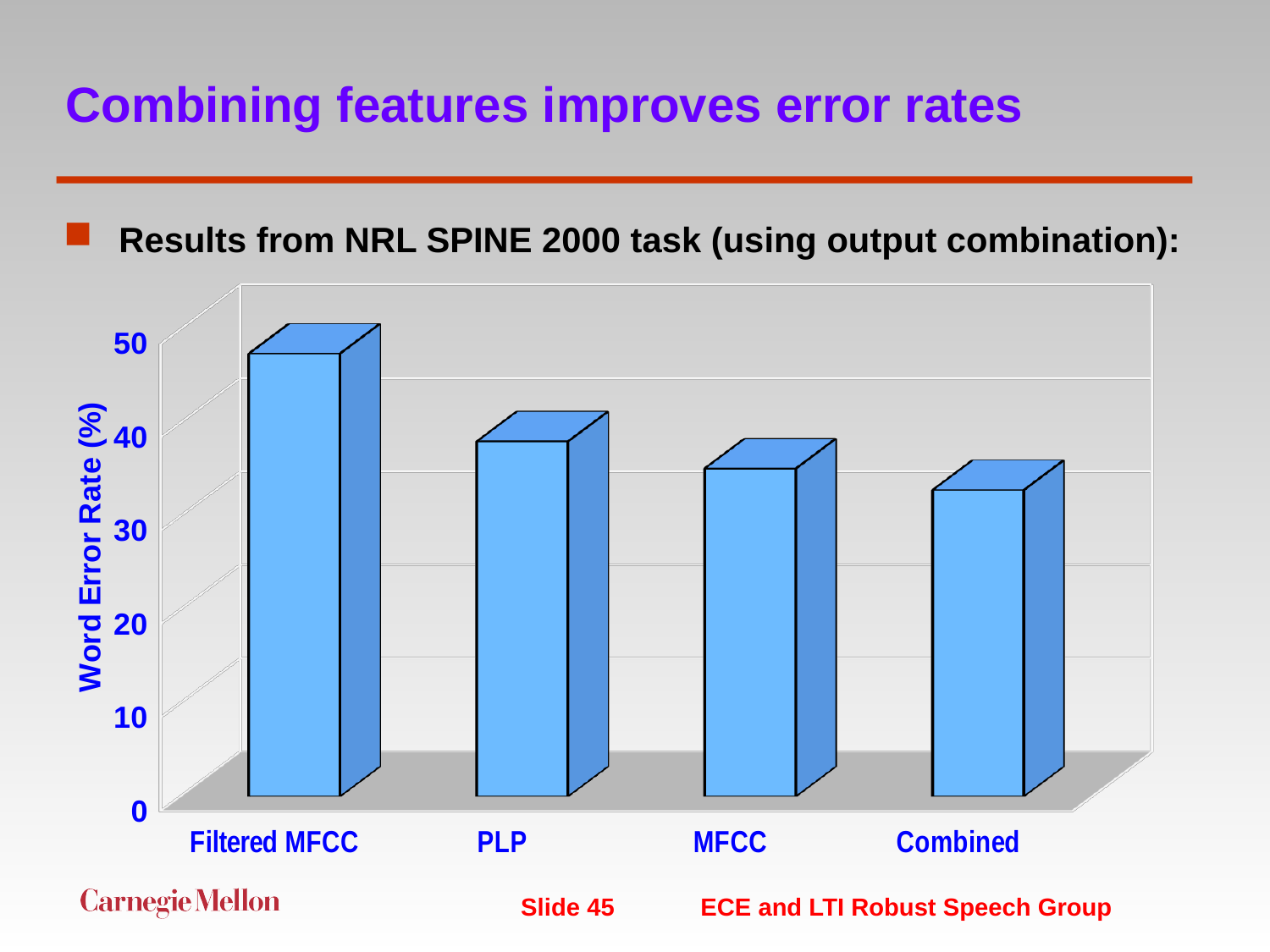
Is the word error rate for MFCC greater or less than 40? less Which has a higher word error rate, Filtered MFCC or Combined? Filtered MFCC What is the label on the vertical axis of the chart? Word Error Rate (%) Is the word error rate for Filtered MFCC greater or less than 40? greater Is the word error rate for Combined greater or less than 40? less How many categories are plotted on the x axis of the chart? 4 Which category has the lowest word error rate? Combined What kind of chart is shown on the slide? bar chart Do the word error rates rise or fall moving from left to right across the categories? fall Which category has the highest word error rate? Filtered MFCC Which has a higher word error rate, PLP or MFCC? PLP